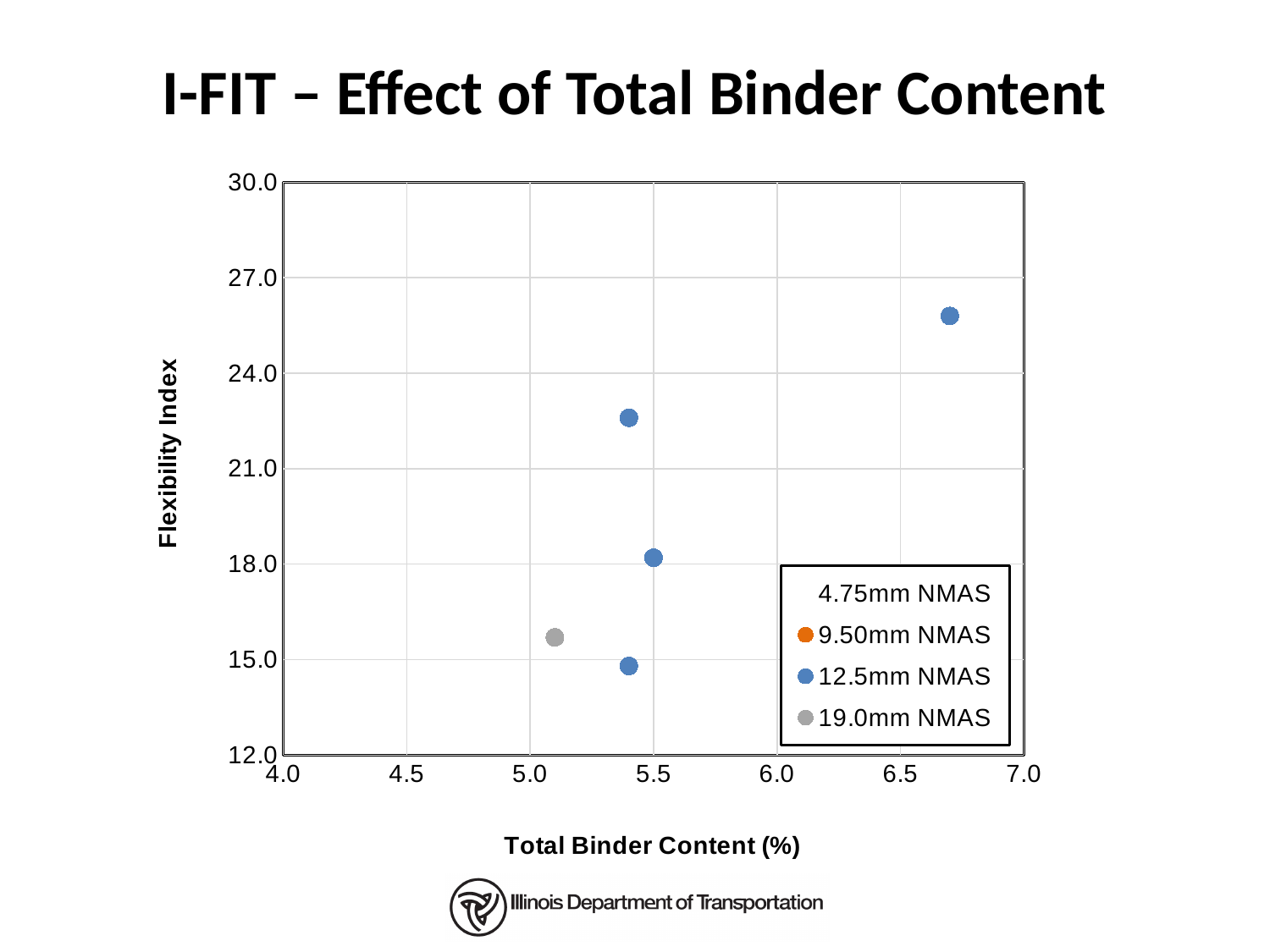
Is the Flexibility Index of the 19.0mm NMAS point greater or less than 18.0? less Is the Flexibility Index of the highest 12.5mm NMAS point greater or less than 24.0? greater How many data points are plotted on the chart in total? 5 What is the label of the x axis? Total Binder Content (%) What is the title of the chart? I-FIT – Effect of Total Binder Content Is the Total Binder Content of the 19.0mm NMAS point greater or less than 5.5? less Which series contains the point with the highest Flexibility Index? 12.5mm NMAS What kind of chart is shown on the slide? scatter chart How many data points are plotted for the 12.5mm NMAS series? 4 How many series does the legend list? 4 How many data points are plotted for the 19.0mm NMAS series? 1